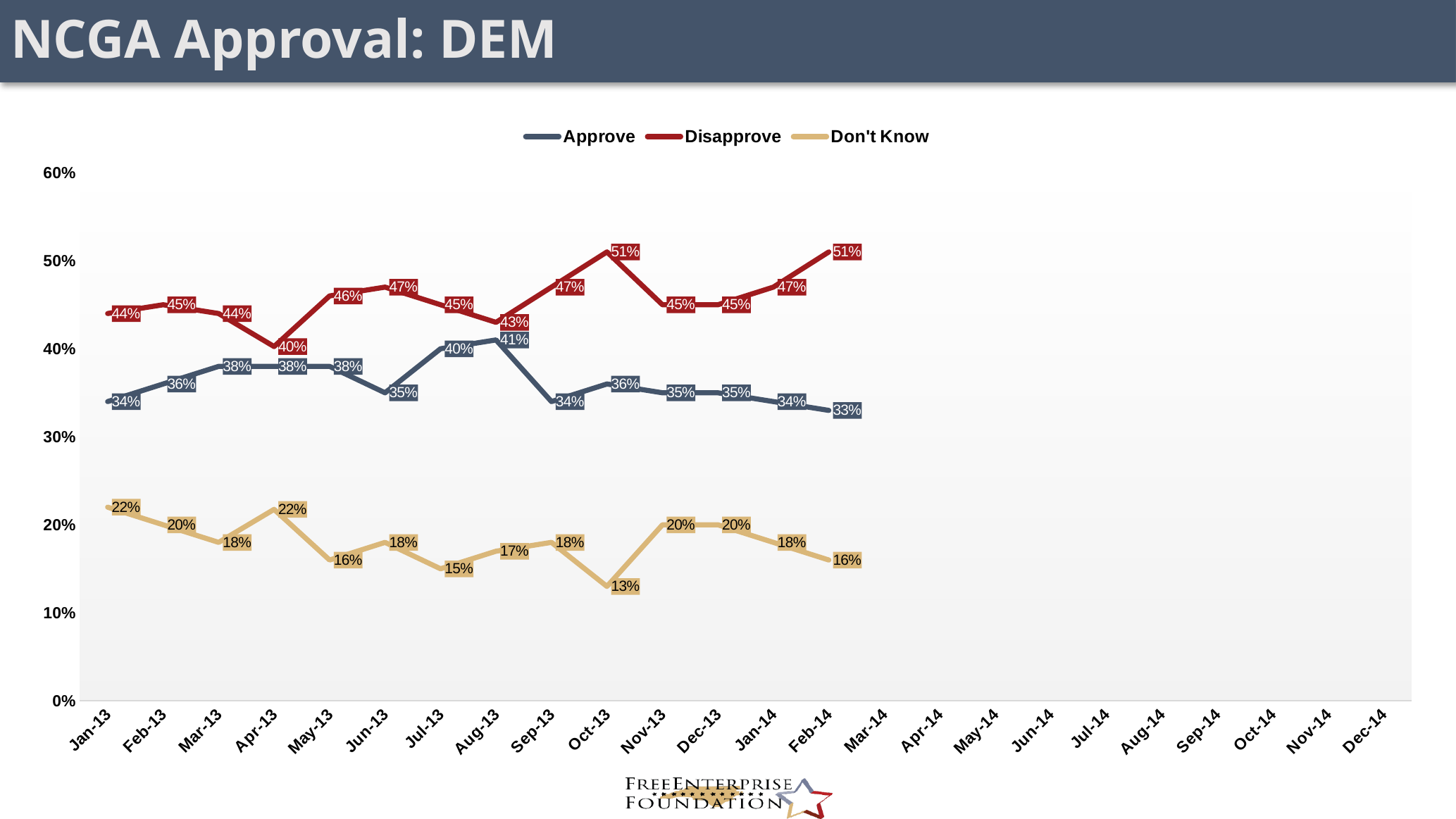
What is the Disapprove value for Apr-13? 40% What type of chart is shown on the slide? line chart What is the Don't Know value for Oct-13? 13% What is the Approve value for Aug-13? 41% What is the difference between the Disapprove and Approve values in Feb-14? 18% In which month is the Don't Know value lowest? Oct-13 Does the Approve series rise or fall from Aug-13 to Feb-14? fall How many series does the legend list? 3 How many months have plotted data points? 14 In which month does the Disapprove series reach its lowest value? Apr-13 In which month does the Approve series reach its highest value? Aug-13 Which is larger in Jun-13, the Approve value or the Disapprove value? Disapprove